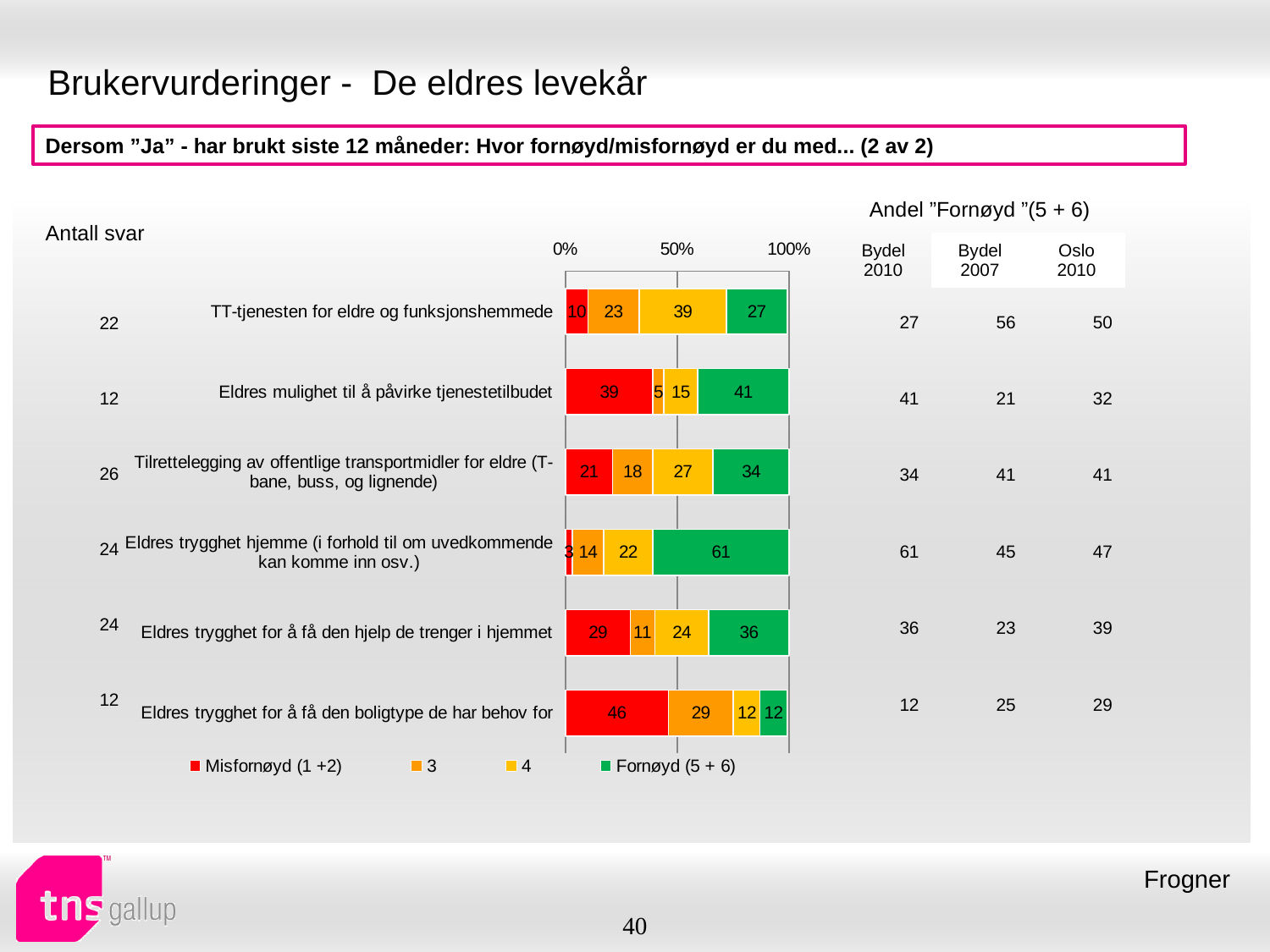
What is the difference between the Misfornøyd (1 +2) values for "Eldres trygghet for å få den boligtype de har behov for" and "Eldres mulighet til å påvirke tjenestetilbudet"? 7 Which colour represents the Fornøyd (5 + 6) series in the chart? Green What is the value of the Misfornøyd (1 +2) series for "Eldres trygghet for å få den boligtype de har behov for"? 46 How many categories are shown in the chart? 6 What kind of chart is shown on the slide? Stacked bar chart Which is larger: the Fornøyd (5 + 6) value for "Tilrettelegging av offentlige transportmidler for eldre (T-bane, buss, og lignende)" or for "TT-tjenesten for eldre og funksjonshemmede"? Tilrettelegging av offentlige transportmidler for eldre (T-bane, buss, og lignende) Which category has the highest Fornøyd (5 + 6) value? Eldres trygghet hjemme (i forhold til om uvedkommende kan komme inn osv.) What is the value of the Fornøyd (5 + 6) series for "Eldres trygghet hjemme (i forhold til om uvedkommende kan komme inn osv.)"? 61 What is the value of series 4 for "TT-tjenesten for eldre og funksjonshemmede"? 39 How many series does the legend list? 4 Which category has the lowest Fornøyd (5 + 6) value? Eldres trygghet for å få den boligtype de har behov for What is the value of series 3 for "Eldres mulighet til å påvirke tjenestetilbudet"? 5